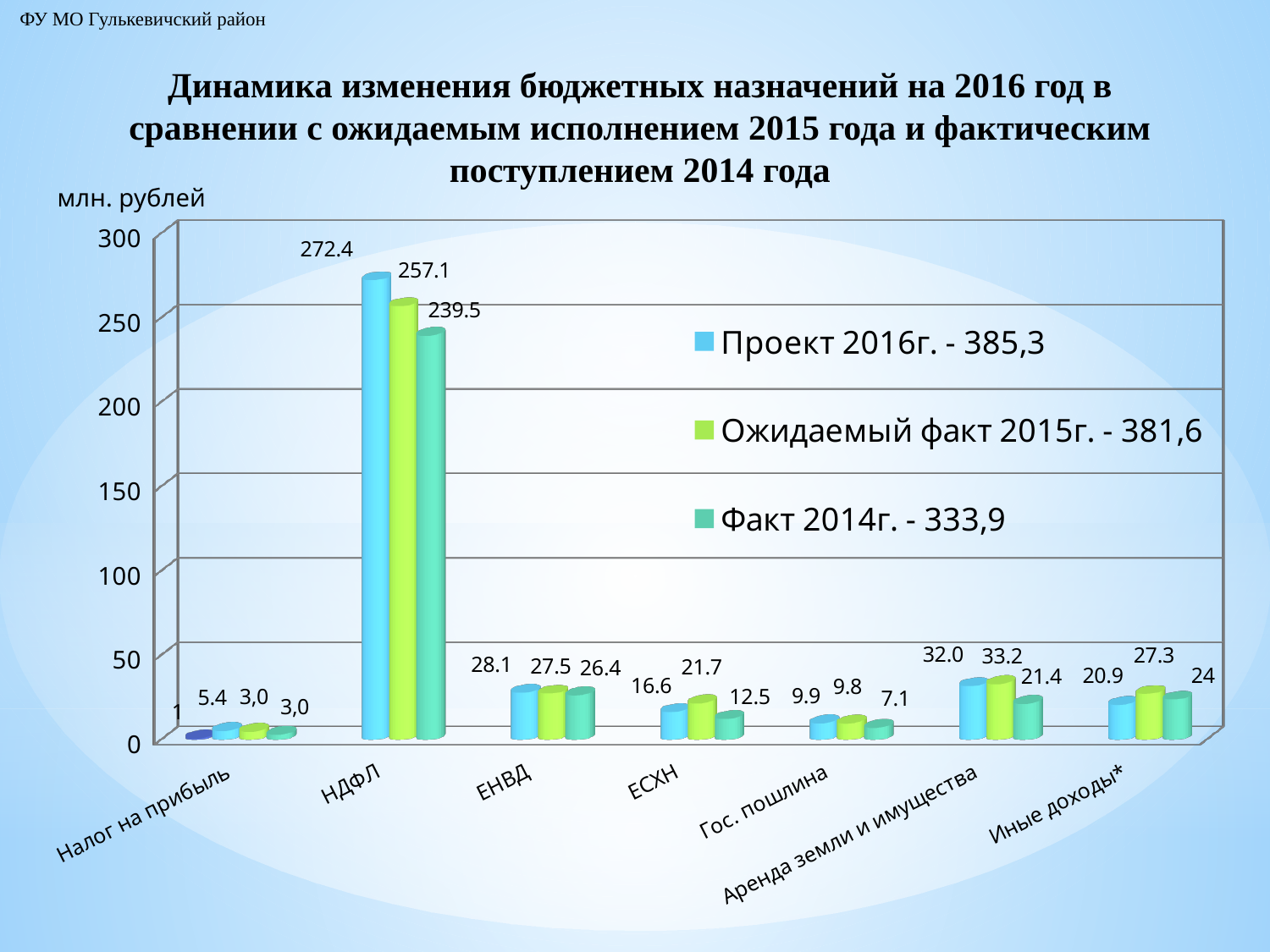
How many series does the legend list? 3 Is the value of Проект 2016г. for НДФЛ greater or less than 250? greater What is the value of Факт 2014г. for Гос. пошлина? 7.1 What is the difference between Проект 2016г. and Факт 2014г. for НДФЛ? 32.9 For ЕСХН, which is larger: Проект 2016г. or Ожидаемый факт 2015г.? Ожидаемый факт 2015г. What is the value of Факт 2014г. for ЕСХН? 12.5 What is the value of Ожидаемый факт 2015г. for Аренда земли и имущества? 33.2 Which category has the highest values across all series? НДФЛ What is the value of Проект 2016г. for НДФЛ? 272.4 What is the difference between Ожидаемый факт 2015г. and Проект 2016г. for Иные доходы*? 6.4 How many categories are shown on the x axis? 7 What kind of chart is shown on the slide? bar chart